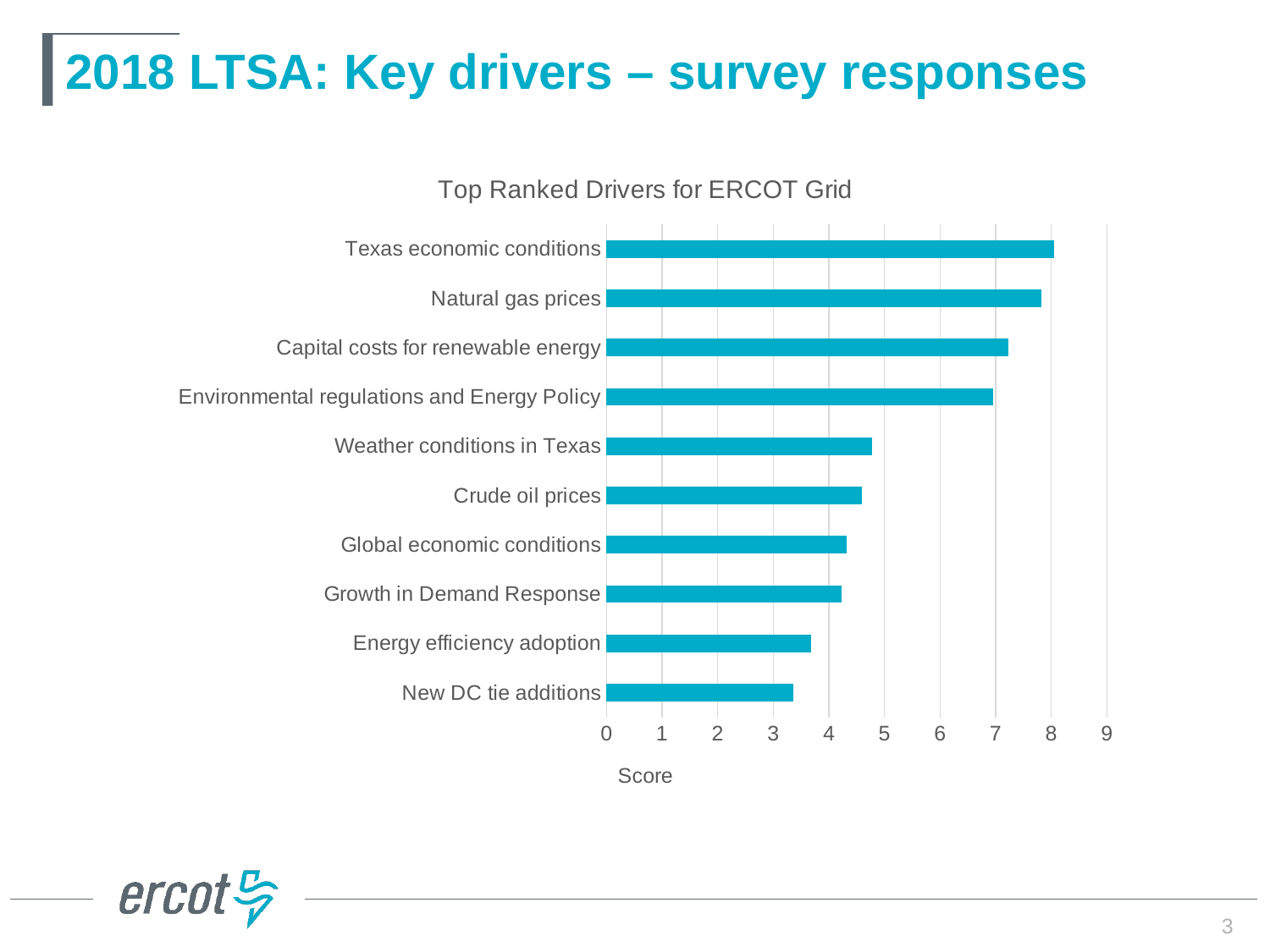
What kind of chart is shown on the slide? bar chart Is the score for Energy efficiency adoption greater or less than 4? less Is the score for Natural gas prices greater or less than 7? greater Is the score for Weather conditions in Texas greater or less than 5? less Which has a higher score, Capital costs for renewable energy or Weather conditions in Texas? Capital costs for renewable energy What is the label on the horizontal axis of the chart? Score What is the title of the chart? Top Ranked Drivers for ERCOT Grid How many drivers are listed in the chart? 10 Which driver has the highest score? Texas economic conditions Which driver has the lowest score? New DC tie additions Which has a higher score, Energy efficiency adoption or New DC tie additions? Energy efficiency adoption